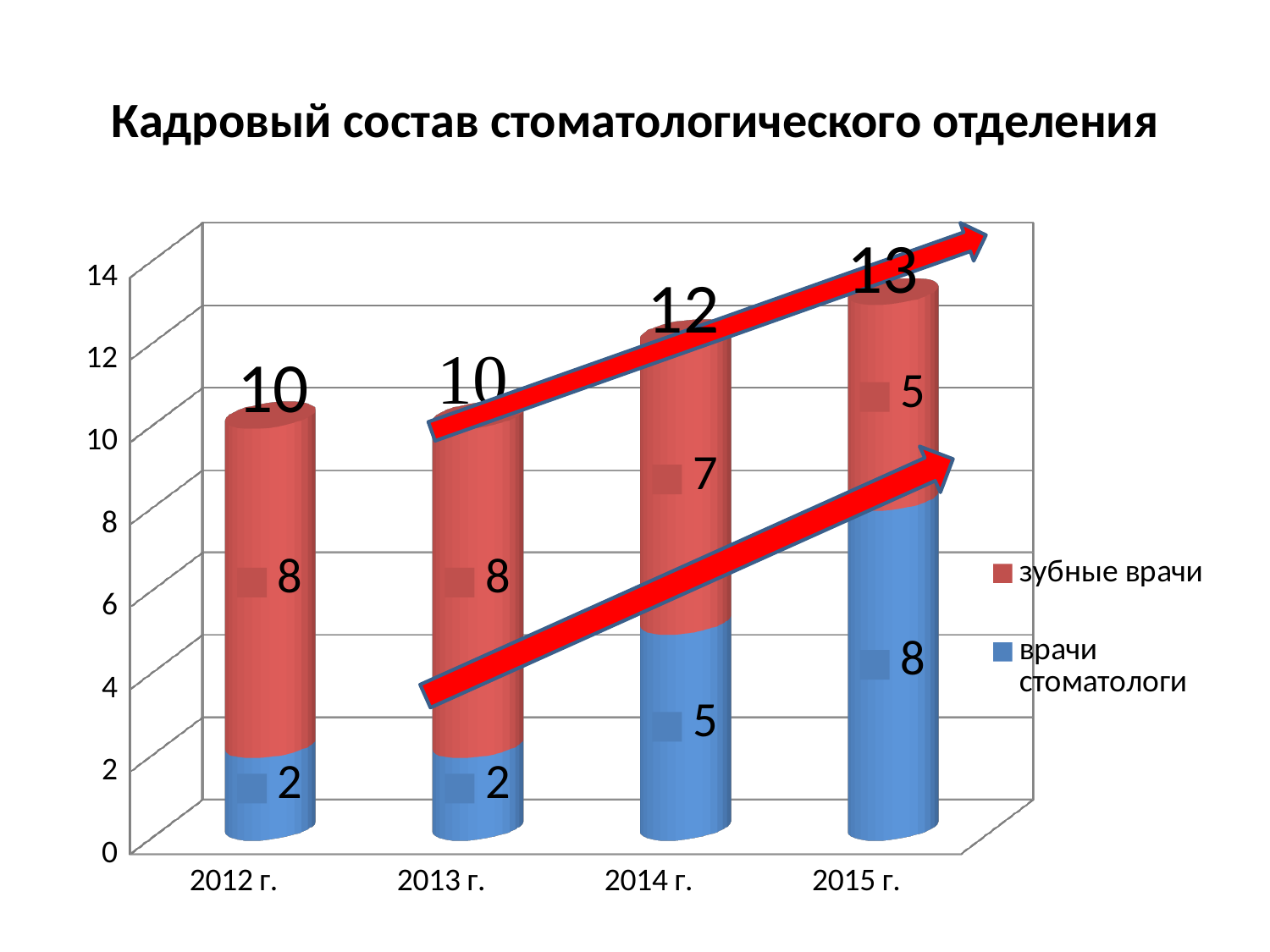
What is the value for зубные врачи in 2015 г.? 5 What is the value for зубные врачи in 2012 г.? 8 What is the value for врачи стоматологи in 2014 г.? 5 Which year has the highest value for врачи стоматологи? 2015 г. What is the total of the stacked bar for 2015 г.? 13 What is the difference between the врачи стоматологи values for 2015 г. and 2012 г.? 6 What is the total of the stacked bar for 2014 г.? 12 Which is larger in 2014 г.: зубные врачи or врачи стоматологи? зубные врачи What kind of chart is shown on the slide? stacked bar chart How many series does the legend list? 2 Which year has the lowest value for зубные врачи? 2015 г. What is the value for врачи стоматологи in 2015 г.? 8